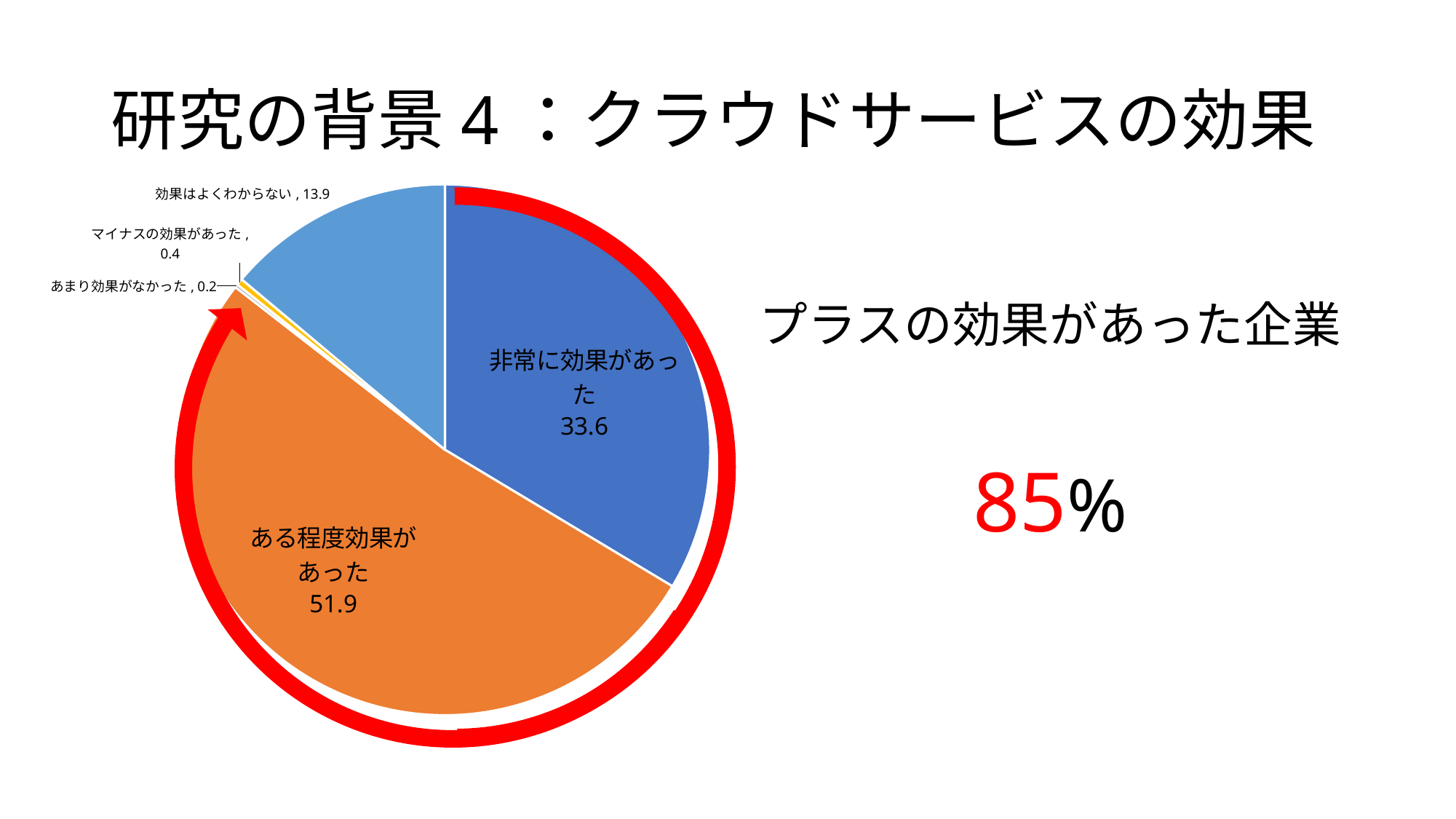
How many categories are shown in the pie chart? 5 Which category has the largest slice of the pie? ある程度効果があった What kind of chart is shown on the slide? pie chart What is the value for 非常に効果があった? 33.6 What is the difference between the values for ある程度効果があった and 非常に効果があった? 18.3 Which is larger, the value for 非常に効果があった or the value for 効果はよくわからない? 非常に効果があった What is the value for マイナスの効果があった? 0.4 What is the title of the slide? 研究の背景４：クラウドサービスの効果 What is the value for 効果はよくわからない? 13.9 What is the value for ある程度効果があった? 51.9 What is the value for あまり効果がなかった? 0.2 Which category has the smallest slice of the pie? あまり効果がなかった